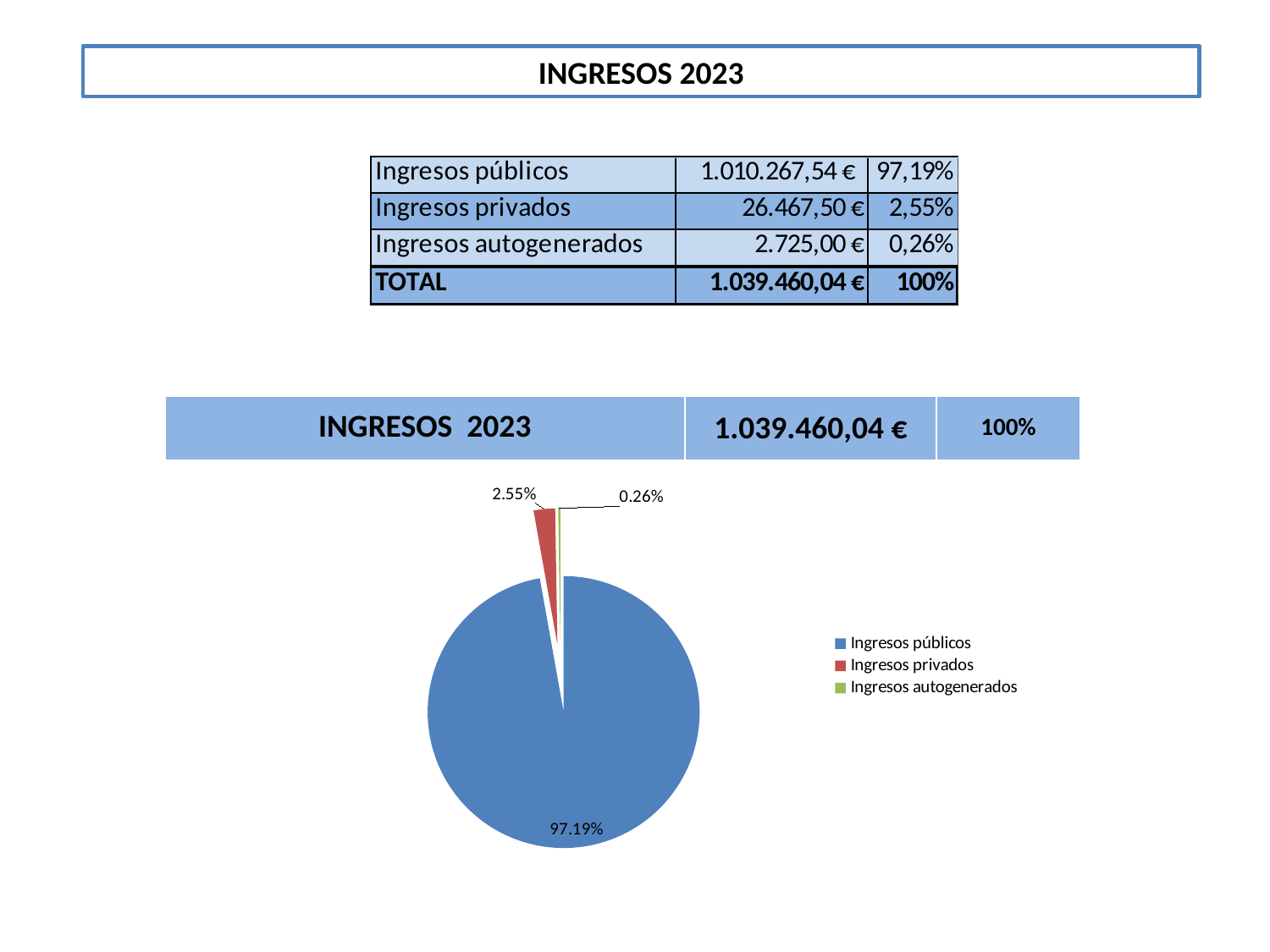
Which legend entry is shown in green in the pie chart? Ingresos autogenerados How many entries does the legend of the pie chart list? 3 What colour is the Ingresos privados slice in the pie chart? Red What share of the pie does Ingresos autogenerados represent? 0.26% Which is larger in the pie chart, Ingresos privados or Ingresos autogenerados? Ingresos privados What share of the pie does Ingresos públicos represent? 97.19% What is the difference in percentage points between the Ingresos privados slice and the Ingresos autogenerados slice? 2.29% What kind of chart is shown on the slide? Pie chart Which category has the largest slice of the pie? Ingresos públicos How many slices does the pie chart have? 3 What share of the pie does Ingresos privados represent? 2.55% Which category has the smallest slice of the pie? Ingresos autogenerados